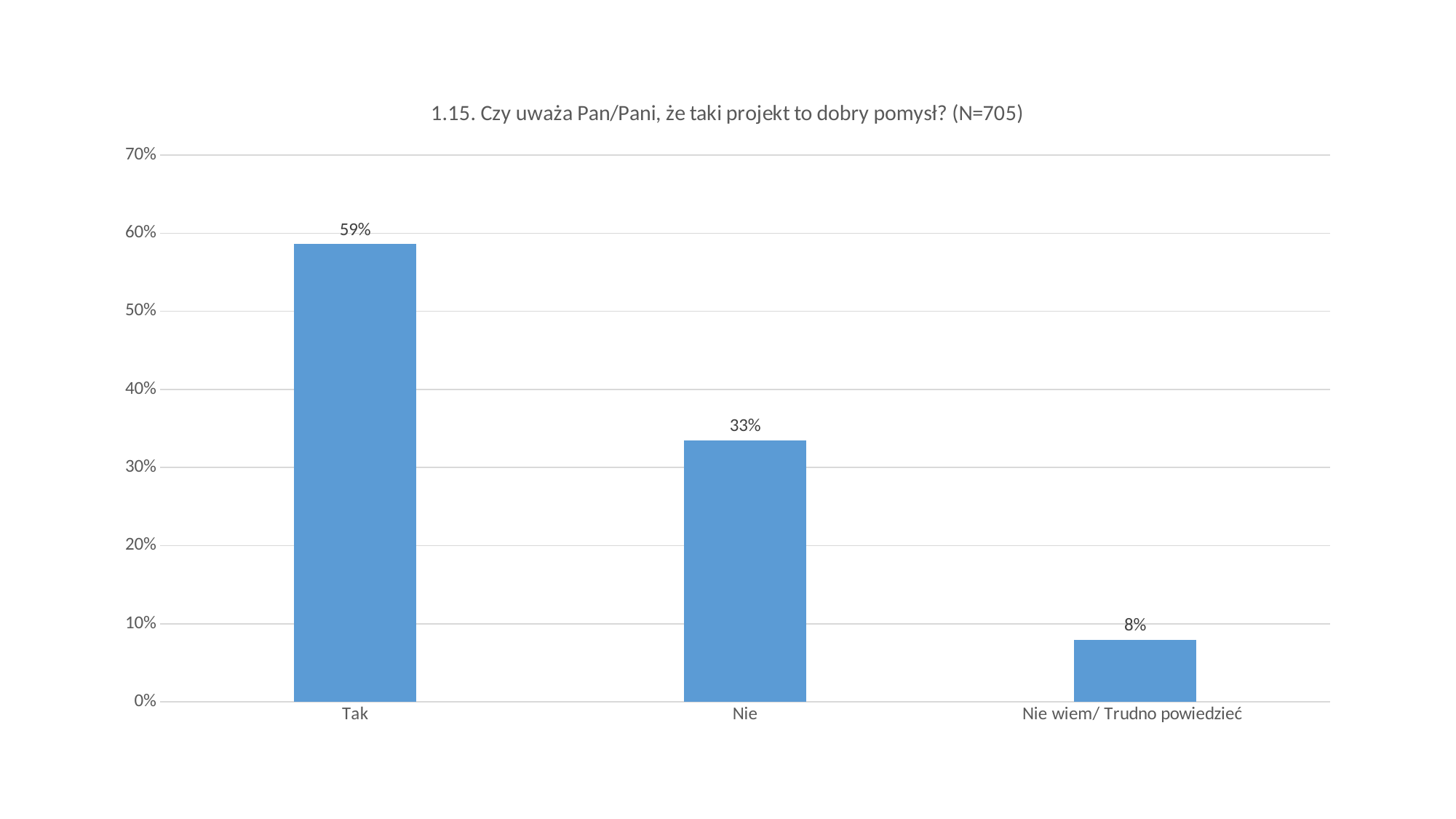
Is the value for Tak greater or less than 50%? greater Which is larger, the value for Nie or the value for Nie wiem/ Trudno powiedzieć? Nie What is the value for Nie? 33% What kind of chart is shown on the slide? bar chart What is the value for Tak? 59% How many categories are shown on the x axis? 3 What is the difference between the values for Nie and Nie wiem/ Trudno powiedzieć? 25% Which category has the lowest value? Nie wiem/ Trudno powiedzieć What is the value for Nie wiem/ Trudno powiedzieć? 8% What is the difference between the values for Tak and Nie? 26% Which category has the highest value? Tak What is the sample size (N) given in the chart title? 705